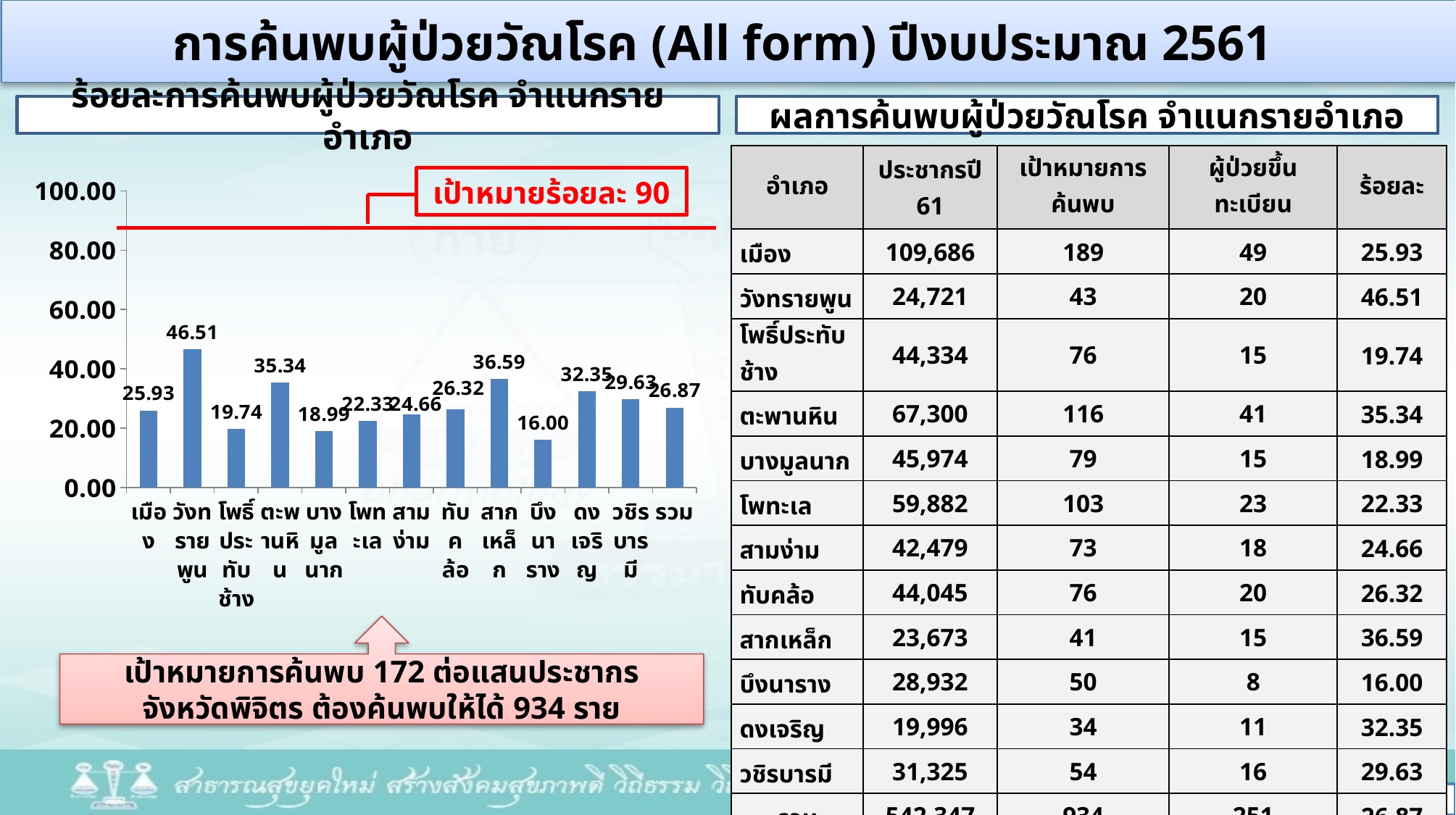
What target percentage does the red line on the chart represent? 90 Is the value for เมือง greater or less than 40.00? less What is the value shown for บึงนาราง in the bar chart? 16.00 What kind of chart is shown on the slide? bar chart How many bars are plotted in the chart? 13 Which is larger, the value for ตะพานหิน or the value for ดงเจริญ? ตะพานหิน Which district has the lowest bar in the chart? บึงนาราง What is the difference between the values for วังทรายพูน and บึงนาราง? 30.51 What is the value shown for สากเหล็ก in the bar chart? 36.59 What is the value shown for วังทรายพูน in the bar chart? 46.51 What is the value shown for รวม in the bar chart? 26.87 Which district has the highest bar in the chart? วังทรายพูน